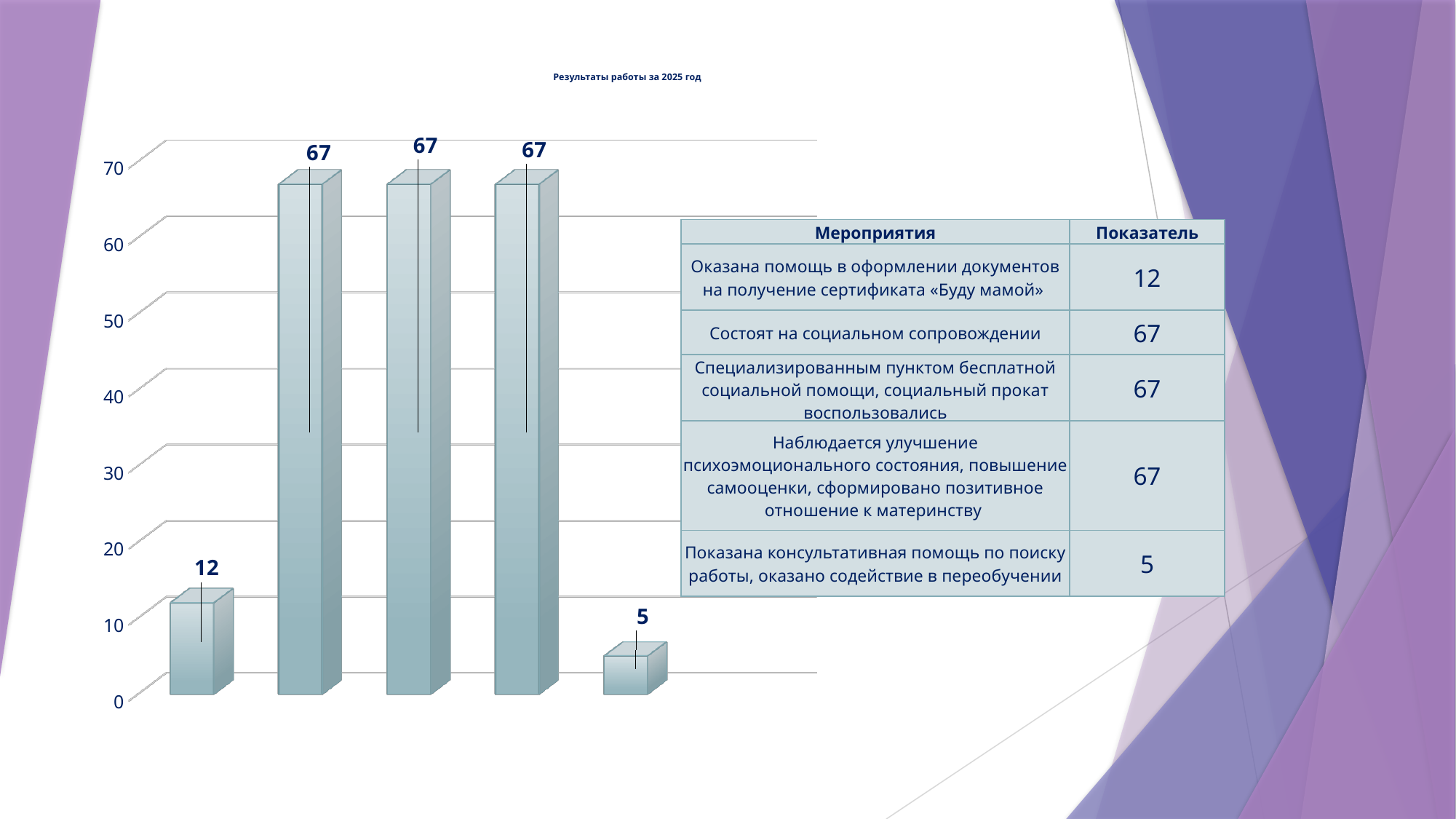
What is the highest value shown by a bar in the chart? 67 What is the difference between the first bar (12) and the last bar (5)? 7 How many bars are plotted in the chart? 5 Which is larger: the first bar or the fifth bar? the first bar What is the difference between the second bar (67) and the first bar (12)? 55 What is the lowest value shown by a bar in the chart? 5 What is the value of the second bar in the chart? 67 What type of chart is shown on the slide? bar chart What is the value of the first (leftmost) bar in the chart? 12 What is the value of the last (rightmost) bar in the chart? 5 What is the title of the chart? Результаты работы за 2025 год How many bars in the chart have the value 67? 3